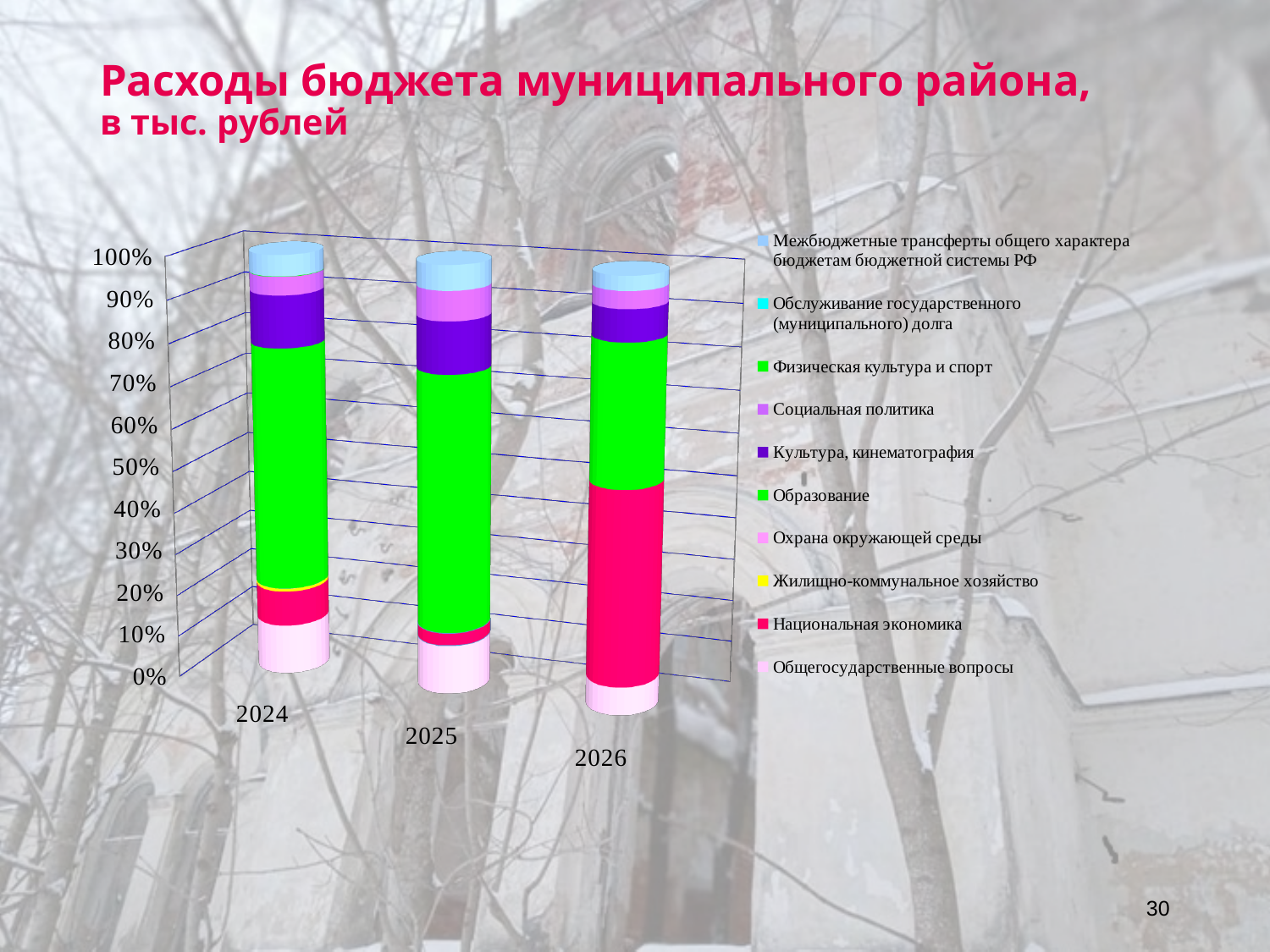
What kind of chart is shown on the slide? Bar chart (stacked) Is the share of Образование in 2024 greater or less than 50%? greater How many series does the chart legend list? 10 How many years (categories) are shown on the x axis of the chart? 3 What is the title of the chart on the slide? Расходы бюджета муниципального района, в тыс. рублей Is the share of Национальная экономика larger in 2024 or in 2026? 2026 Is the share of Национальная экономика in 2026 greater or less than 20%? greater Is the share of Образование larger in 2025 or in 2026? 2025 Which colour represents Образование in the chart legend? Green In which year is the share of Национальная экономика the largest? 2026 In which year is the share of Образование the smallest? 2026 Is the share of Культура, кинематография in 2025 greater or less than 30%? less